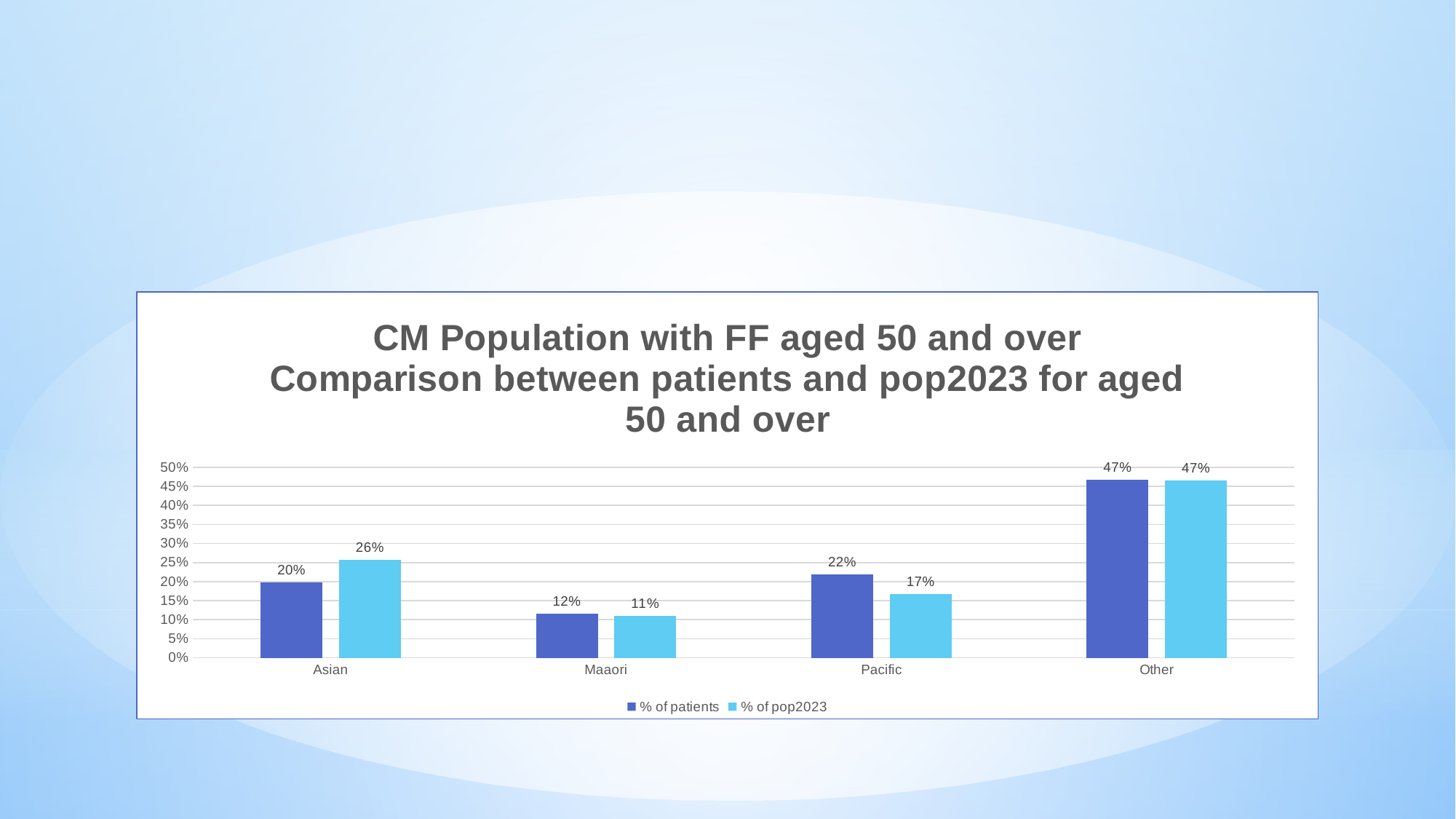
Is the % of patients value for Other greater or less than 40%? greater How many series does the legend list? 2 What is the % of pop2023 value for Pacific? 17% What is the % of patients value for Asian? 20% Which category has the lowest % of pop2023 value? Maaori What kind of chart is shown on the slide? Bar chart What are the two series named in the legend? % of patients and % of pop2023 Which category has the highest % of patients value? Other What is the difference between the % of pop2023 and % of patients values for Asian? 6% What is the % of patients value for Maaori? 12% How many categories are shown on the x axis? 4 Which is larger for Pacific: % of patients or % of pop2023? % of patients